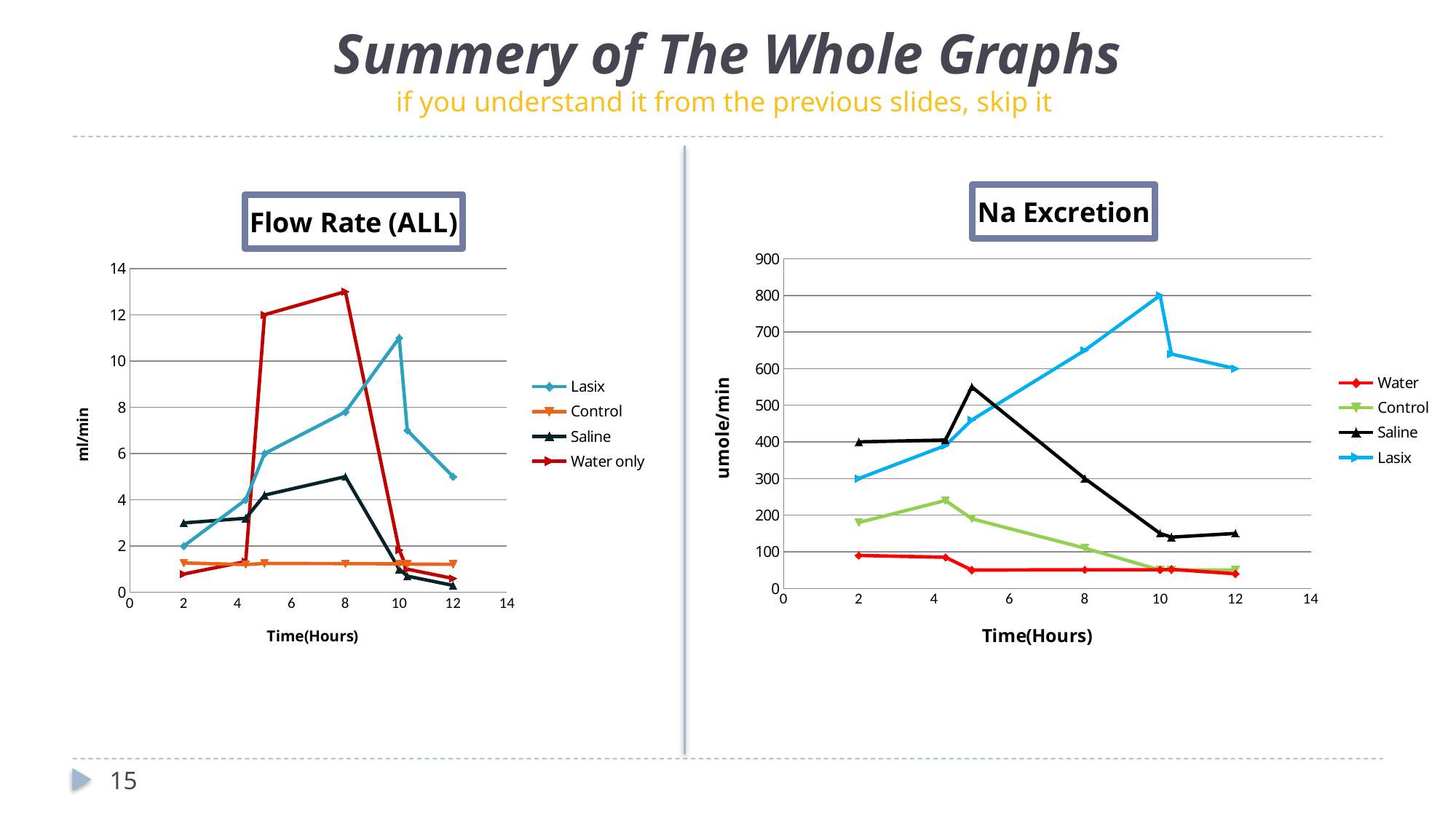
How many series does the legend of the Na Excretion chart list? 4 In the Flow Rate (ALL) chart, is the Water only value at 8 hours greater or less than 12? greater How many series does the legend of the Flow Rate (ALL) chart list? 4 In the Na Excretion chart, what is the Lasix value at 2 hours? 300 In the Na Excretion chart, what is the Saline value at 2 hours? 400 In the Na Excretion chart, which series has the highest value at 10 hours? Lasix In the Na Excretion chart, which is larger at 8 hours, Saline or Control? Saline In the Na Excretion chart, does the Saline series rise or fall between 5 hours and 10 hours? fall In the Flow Rate (ALL) chart, which series reaches the highest value on the chart? Water only In the Na Excretion chart, what is the Lasix value at 10 hours? 800 What kind of chart is the Flow Rate (ALL) chart? line chart